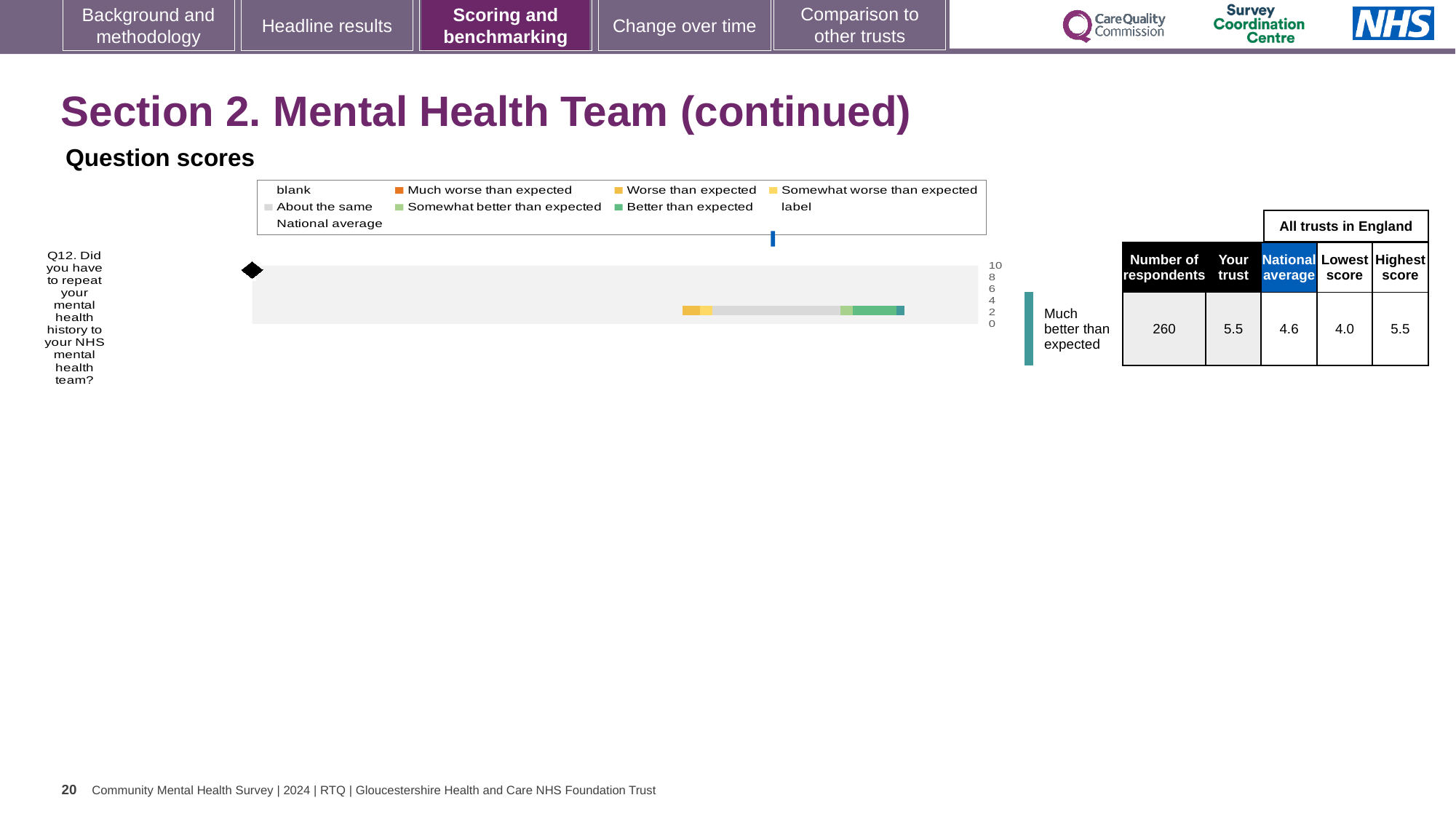
In the table beside the chart, what is the Highest score among all trusts in England for Q12? 5.5 For Q12, what is the difference between the Highest score and the Lowest score among all trusts in England? 1.5 In the table beside the chart, what is the Lowest score among all trusts in England for Q12? 4.0 What benchmark category is shown to the right of the Q12 bar? Much better than expected For Q12, what is the difference between the 'Your trust' score and the National average? 0.9 Which question is plotted in the Question scores chart? Q12. Did you have to repeat your mental health history to your NHS mental health team? How many respondents answered Q12 according to the table beside the chart? 260 In the table beside the chart, what is the 'Your trust' score for Q12? 5.5 What kind of chart is shown under 'Question scores'? bar chart In the table beside the chart, what is the National average score for Q12? 4.6 How many survey questions are plotted in the Question scores chart? 1 For Q12, which is larger: the 'Your trust' score or the National average? Your trust